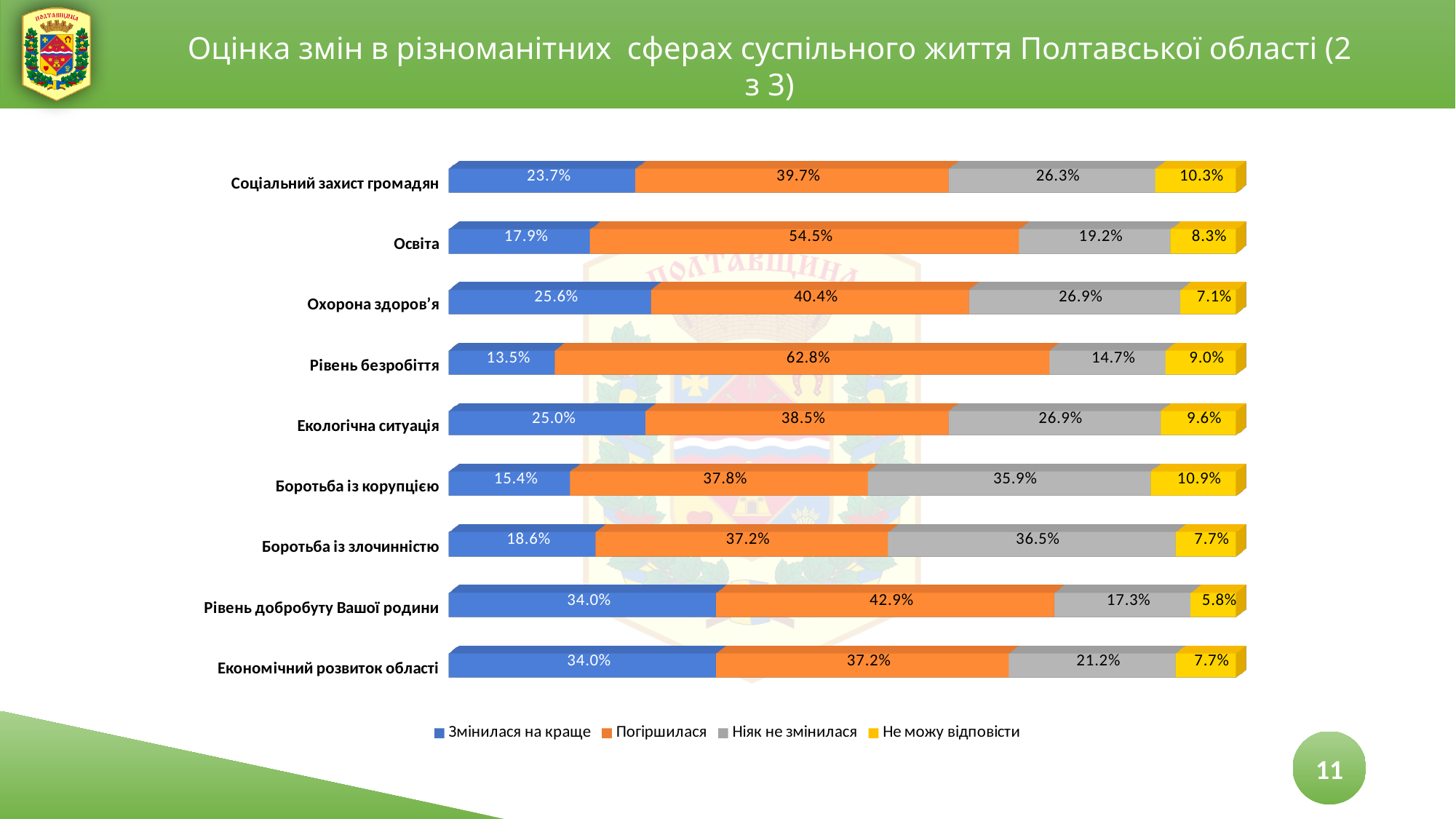
What percentage of respondents said that social protection of citizens (Соціальний захист громадян) changed for the better (Змінилася на краще)? 23.7% How many series does the legend list? 4 What type of chart is shown on the slide? Stacked horizontal bar chart Which category has the lowest value for the 'Змінилася на краще' series? Рівень безробіття Which category has the highest value for the 'Погіршилася' series? Рівень безробіття Which category has the highest 'Не можу відповісти' value? Боротьба із корупцією Which colour represents the 'Ніяк не змінилася' series in the chart? Grey For Боротьба із злочинністю, which is larger: the 'Погіршилася' value or the 'Ніяк не змінилася' value? Погіршилася (37.2%) For Освіта, what is the difference between the 'Погіршилася' value and the 'Змінилася на краще' value? 36.6 percentage points How many categories (spheres of public life) are shown on the chart? 9 What share of respondents could not answer (Не можу відповісти) about Рівень добробуту Вашої родини? 5.8% What is the value of the 'Погіршилася' series for Освіта? 54.5%